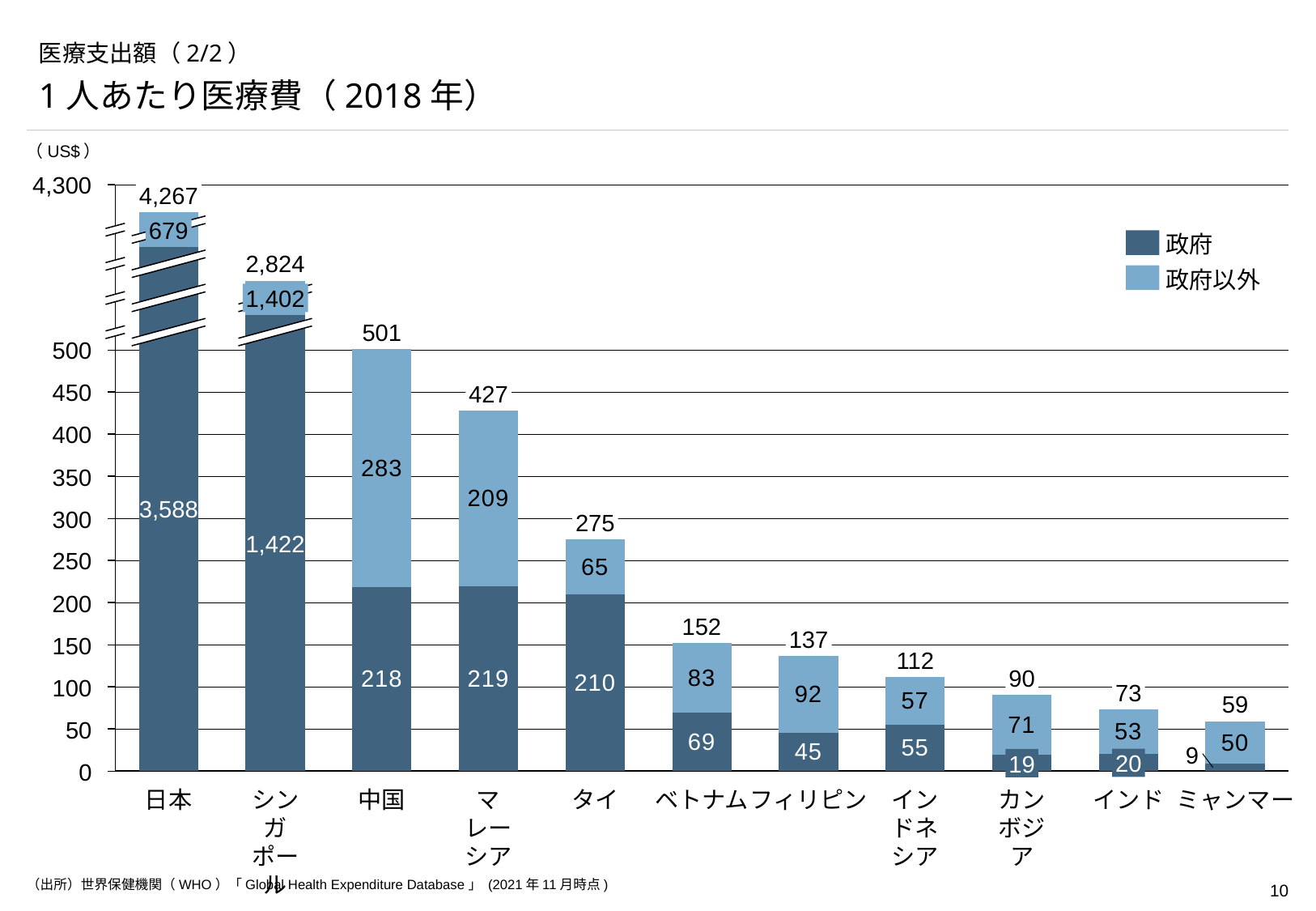
What is the difference between the total for 中国 and the total for マレーシア? 74 How many countries are shown on the x axis? 11 What is the 政府 (government) value for シンガポール? 1,422 What unit is indicated for the values on the chart? US$ How many series does the legend list? 2 What kind of chart is shown on the slide? Stacked bar chart Which is larger, the 政府以外 value for ベトナム or the 政府以外 value for フィリピン? フィリピン Which country has the lowest total per-capita health expenditure? ミャンマー What is the total of the stacked bar for カンボジア? 90 What is the total per-capita health expenditure shown for 日本? 4,267 Which country has the highest total per-capita health expenditure? 日本 What is the 政府以外 value for 中国? 283